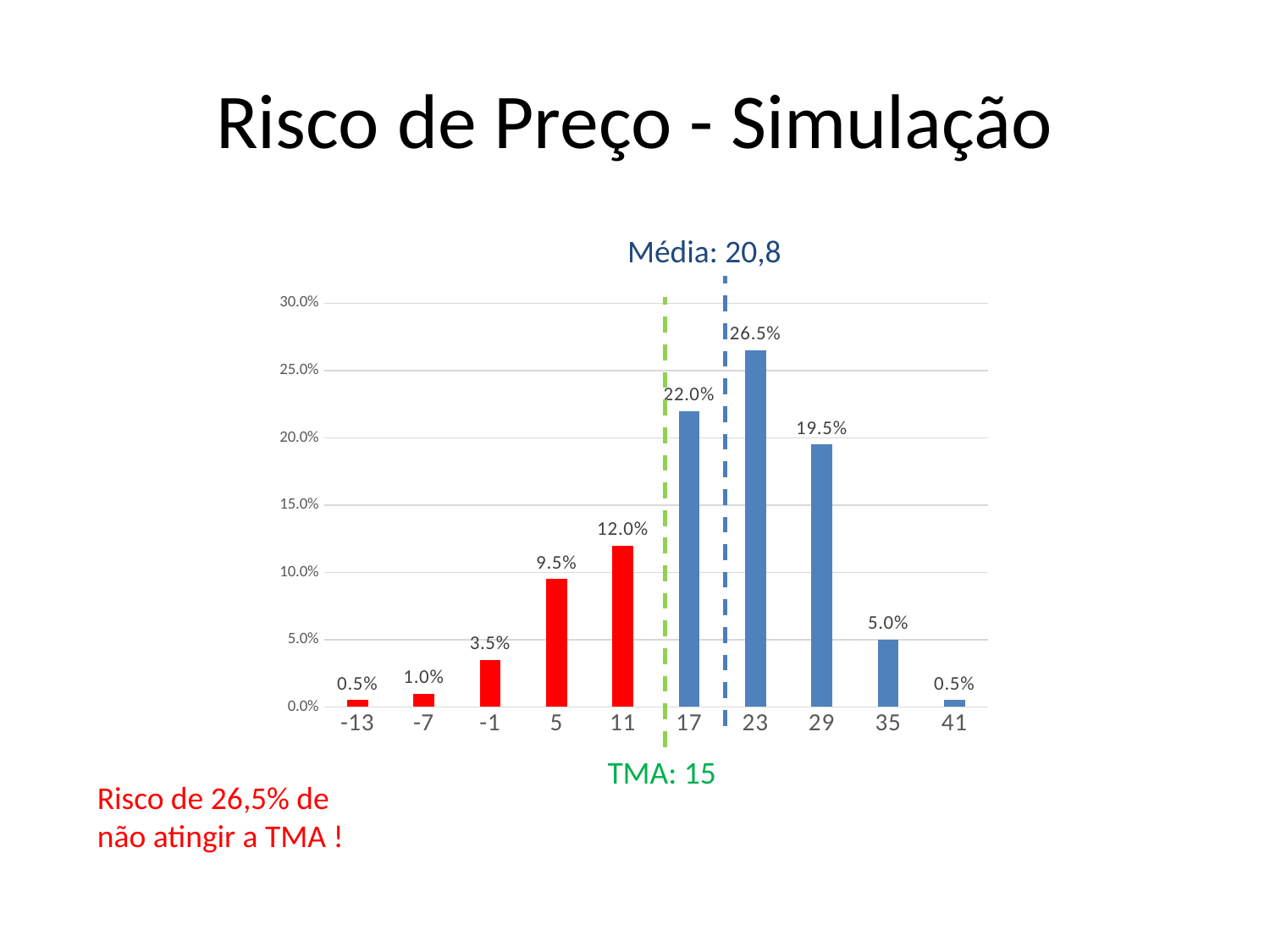
What value does the label 'Média' give? 20,8 What is the value for category 23? 26.5% What is the value for category 29? 19.5% How many categories are shown on the x axis? 10 What kind of chart is shown? bar chart What is the total of the red bars (-13, -7, -1, 5, 11)? 26.5% What is the difference between the values for 23 and 17? 4.5% What value does the label 'TMA' give? 15 What is the value for category 11? 12.0% Is the value for 17 greater or less than 20.0%? greater Which is larger, the value for 5 or the value for 35? 5 Which category has the highest value? 23